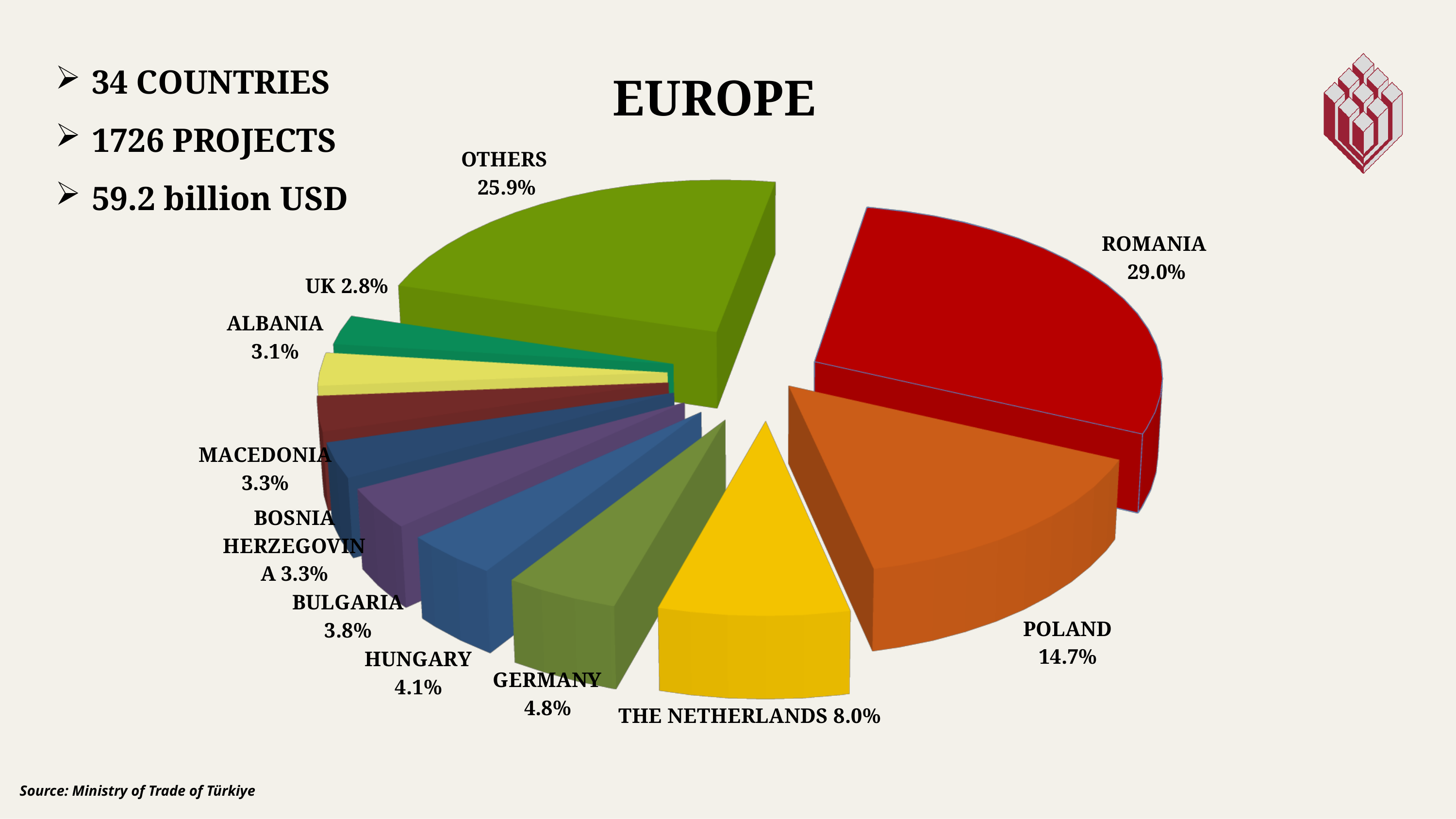
What is the value shown for Hungary? 4.1% How many slices does the pie chart have? 11 What share of the pie does Romania hold? 29.0% What percentage is shown for The Netherlands? 8.0% Which slice has the smallest share of the pie? UK Which country slice has the largest share of the pie? Romania What is the value shown for Poland? 14.7% What is the title of the chart? EUROPE Which is larger, the share for Germany or the share for Bulgaria? Germany What colour is the Romania slice? Red What is the difference between the shares of Romania and Poland? 14.3% What kind of chart is shown on the slide? Pie chart